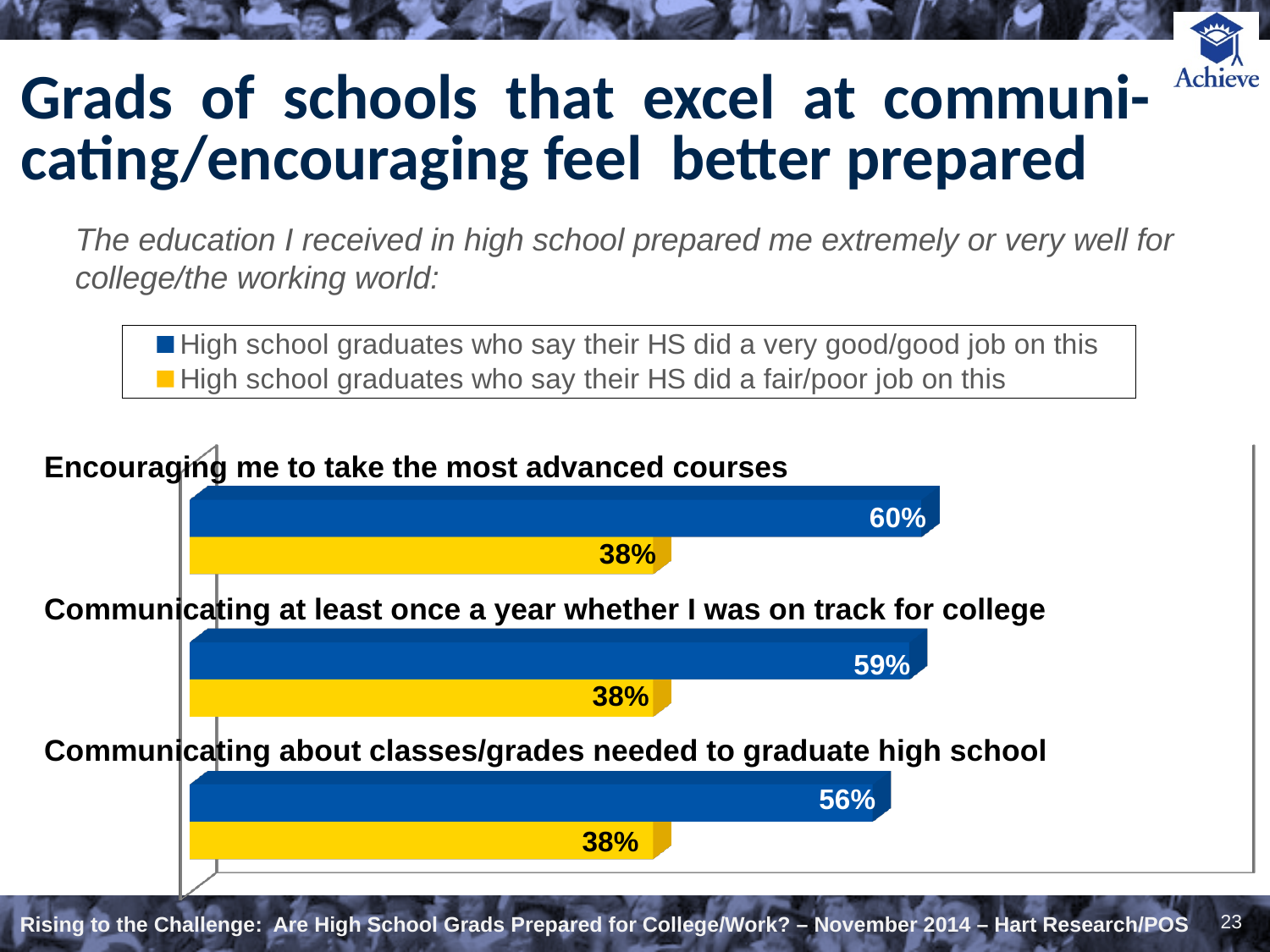
What is the value for the very good/good job group for 'Communicating at least once a year whether I was on track for college'? 59% What percentage of high school graduates who say their HS did a very good/good job on encouraging them to take the most advanced courses feel extremely or very well prepared? 60% What is the difference between the very good/good job group and the fair/poor job group for 'Encouraging me to take the most advanced courses'? 22 percentage points How many categories are shown in the chart? 3 What percentage of high school graduates who say their HS did a fair/poor job on communicating about classes/grades needed to graduate high school feel extremely or very well prepared? 38% Which category has the highest value for the very good/good job group? Encouraging me to take the most advanced courses For 'Communicating at least once a year whether I was on track for college', which group has the larger value: very good/good job or fair/poor job? Very good/good job What is the difference between the very good/good job group and the fair/poor job group for 'Communicating about classes/grades needed to graduate high school'? 18 percentage points What is the value for the very good/good job group for 'Communicating about classes/grades needed to graduate high school'? 56% Which category has the lowest value for the very good/good job group? Communicating about classes/grades needed to graduate high school How many series does the legend list? 2 What kind of chart is shown on the slide? Bar chart